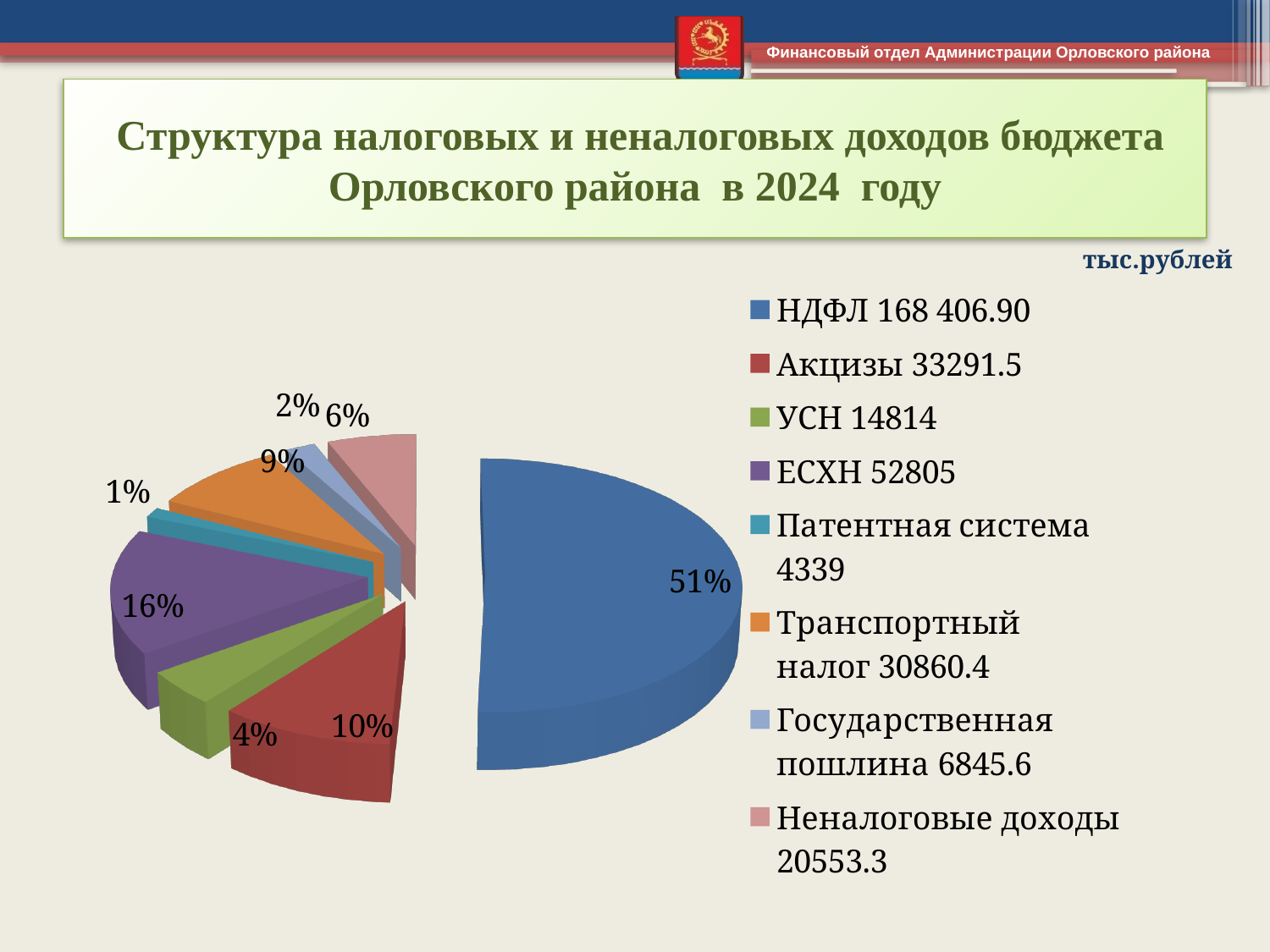
What share of the pie does ЕСХН account for? 16% Which is larger, the value for ЕСХН or the value for Акцизы? ЕСХН What share of the pie does НДФЛ account for? 51% What is the difference between the value for ЕСХН and the value for Акцизы? 19513.5 What kind of chart is shown on the slide? pie chart What value is shown for НДФЛ in the legend? 168 406.90 Which category has the largest slice of the pie? НДФЛ Which category has the smallest slice of the pie? Патентная система How many categories does the legend of the pie chart list? 8 What value is shown for Неналоговые доходы in the legend? 20553.3 What value is shown for Транспортный налог in the legend? 30860.4 What share of the pie does Патентная система account for? 1%